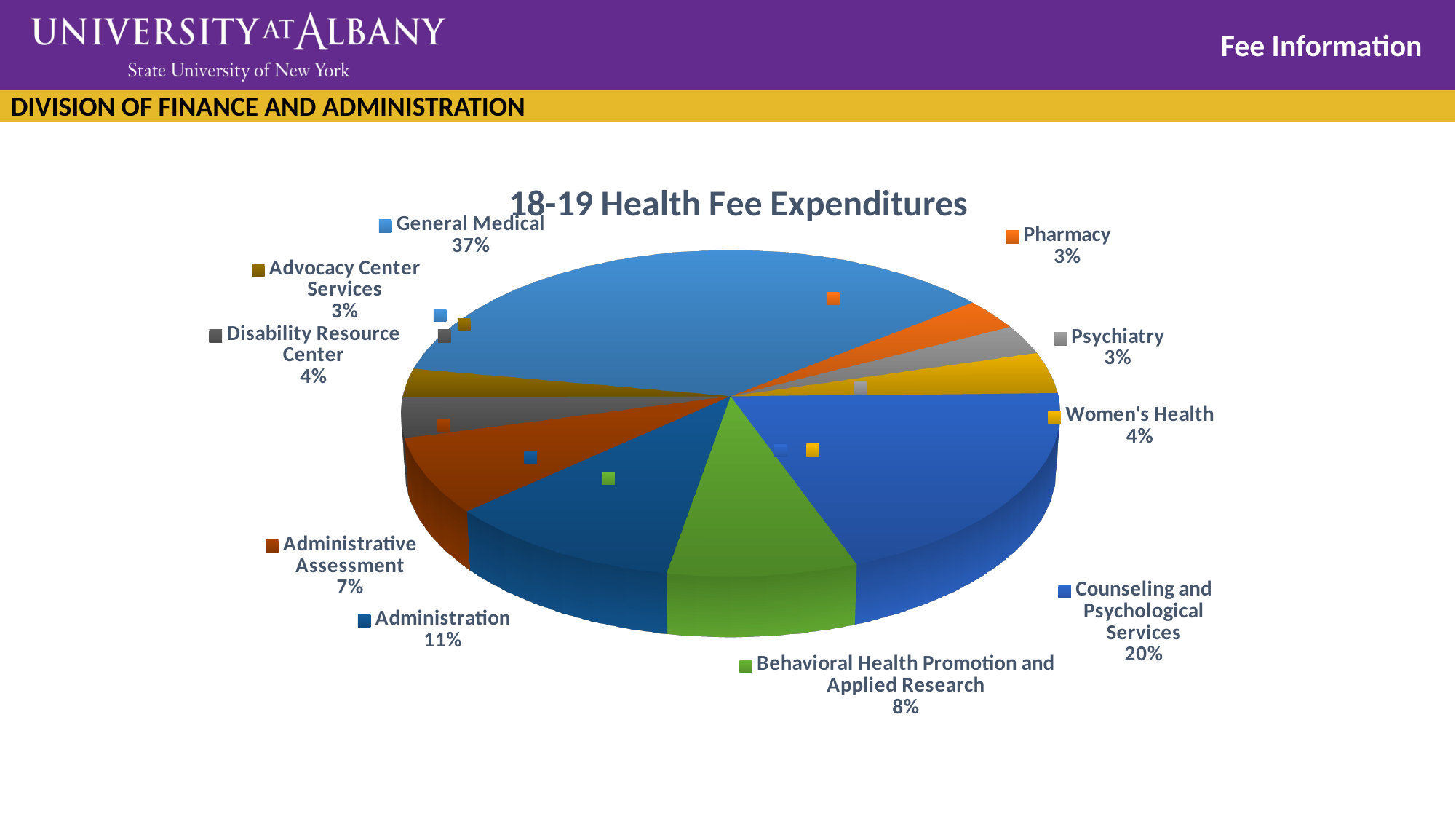
Which category has the largest share of the pie? General Medical What share of the 18-19 Health Fee Expenditures goes to General Medical? 37% What percentage is shown for Women's Health? 4% What percentage is shown for Behavioral Health Promotion and Applied Research? 8% What is the title of the chart? 18-19 Health Fee Expenditures What percentage is shown for Administration? 11% What kind of chart is shown on the slide? Pie chart How many categories are shown in the pie chart? 10 What is the difference in percentage points between General Medical and Counseling and Psychological Services? 17 Which is larger, the share for Administration or the share for Administrative Assessment? Administration What is the combined share of Pharmacy, Psychiatry and Advocacy Center Services? 9% What percentage is shown for Counseling and Psychological Services? 20%